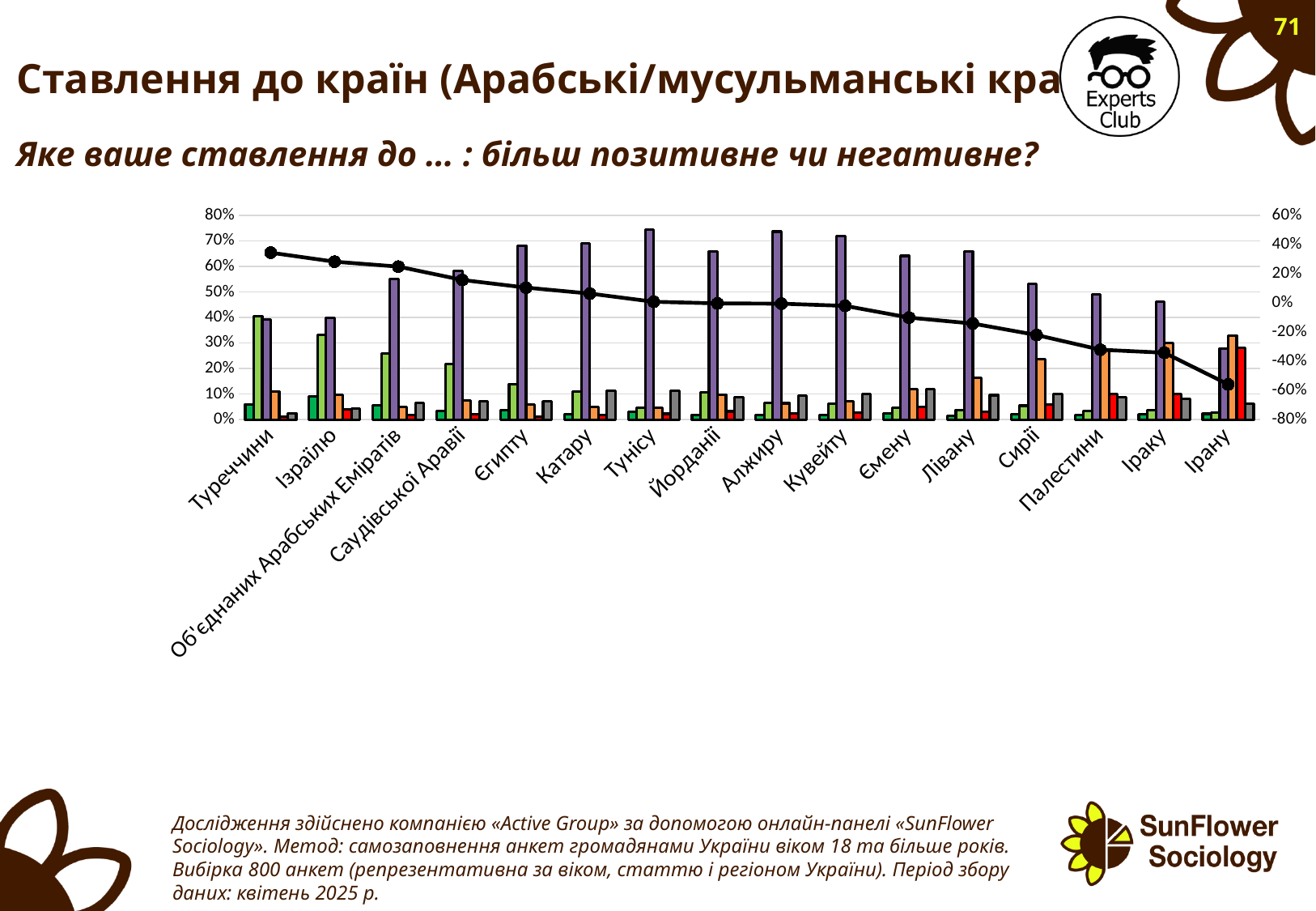
What kind of chart is shown on the slide? bar chart with a line Does the black line rise or fall from Туреччини to Ірану along the x axis? fall Is the black line point for Туреччини greater or less than 20% on the right axis? greater Is the red bar for Ірану greater or less than 20% on the left axis? greater Is the orange bar for Палестини greater or less than 20% on the left axis? greater Which country is the first category on the x axis of the chart? Туреччини How many countries are shown on the x axis of the chart? 16